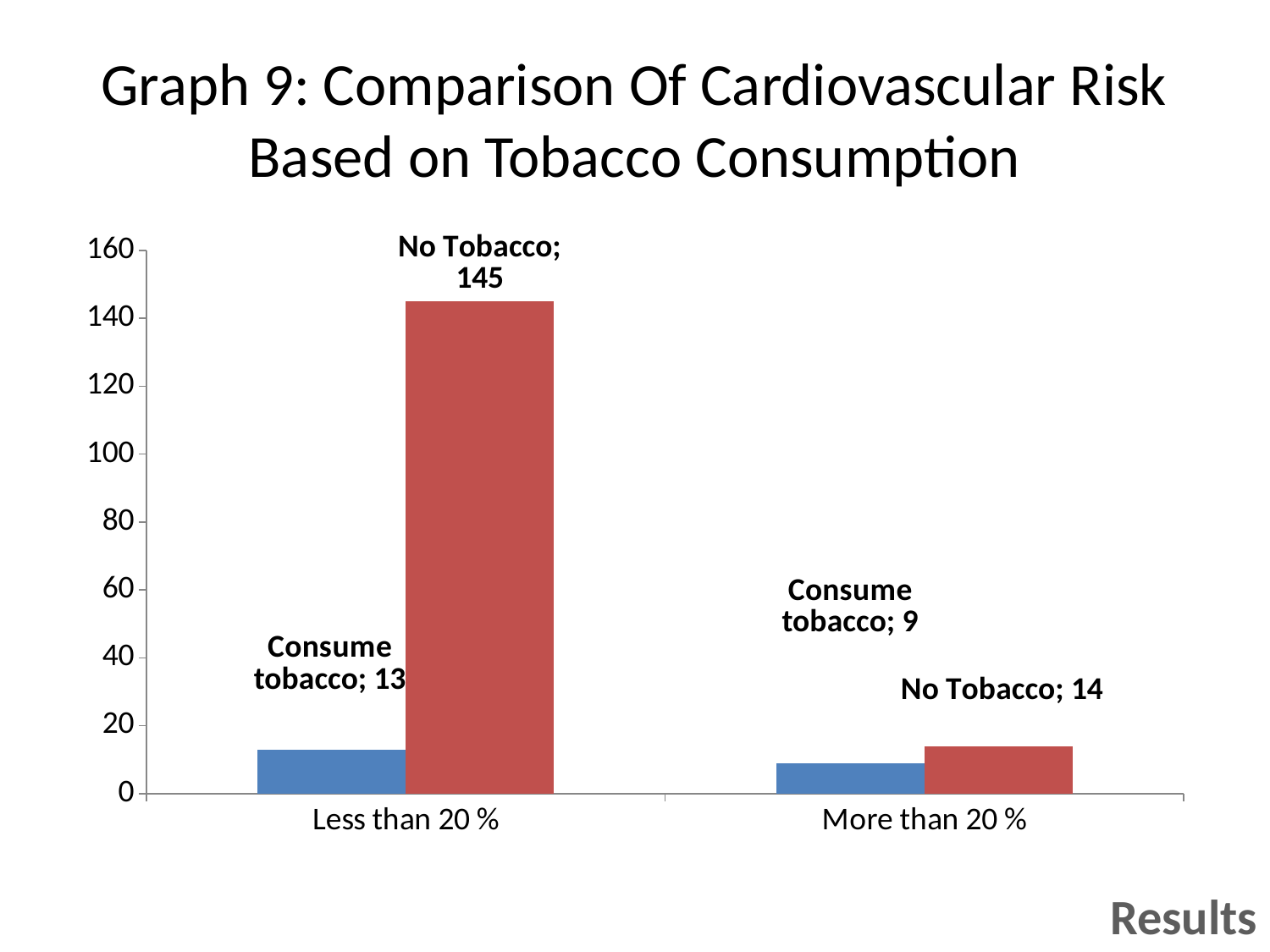
How many categories are shown on the x axis? 2 What is the title of the chart? Graph 9: Comparison Of Cardiovascular Risk Based on Tobacco Consumption What is the difference between the No Tobacco and Consume tobacco values in the More than 20 % category? 5 Which bar has the highest value on the chart? No Tobacco, Less than 20 % What is the value for No Tobacco in the More than 20 % category? 14 What is the value for Consume tobacco in the Less than 20 % category? 13 What kind of chart is shown on the slide? Bar chart What is the value for No Tobacco in the Less than 20 % category? 145 What is the difference between the No Tobacco and Consume tobacco values in the Less than 20 % category? 132 What is the value for Consume tobacco in the More than 20 % category? 9 Which bar has the lowest value on the chart? Consume tobacco, More than 20 % Which is larger: Consume tobacco in Less than 20 % or Consume tobacco in More than 20 %? Consume tobacco in Less than 20 %